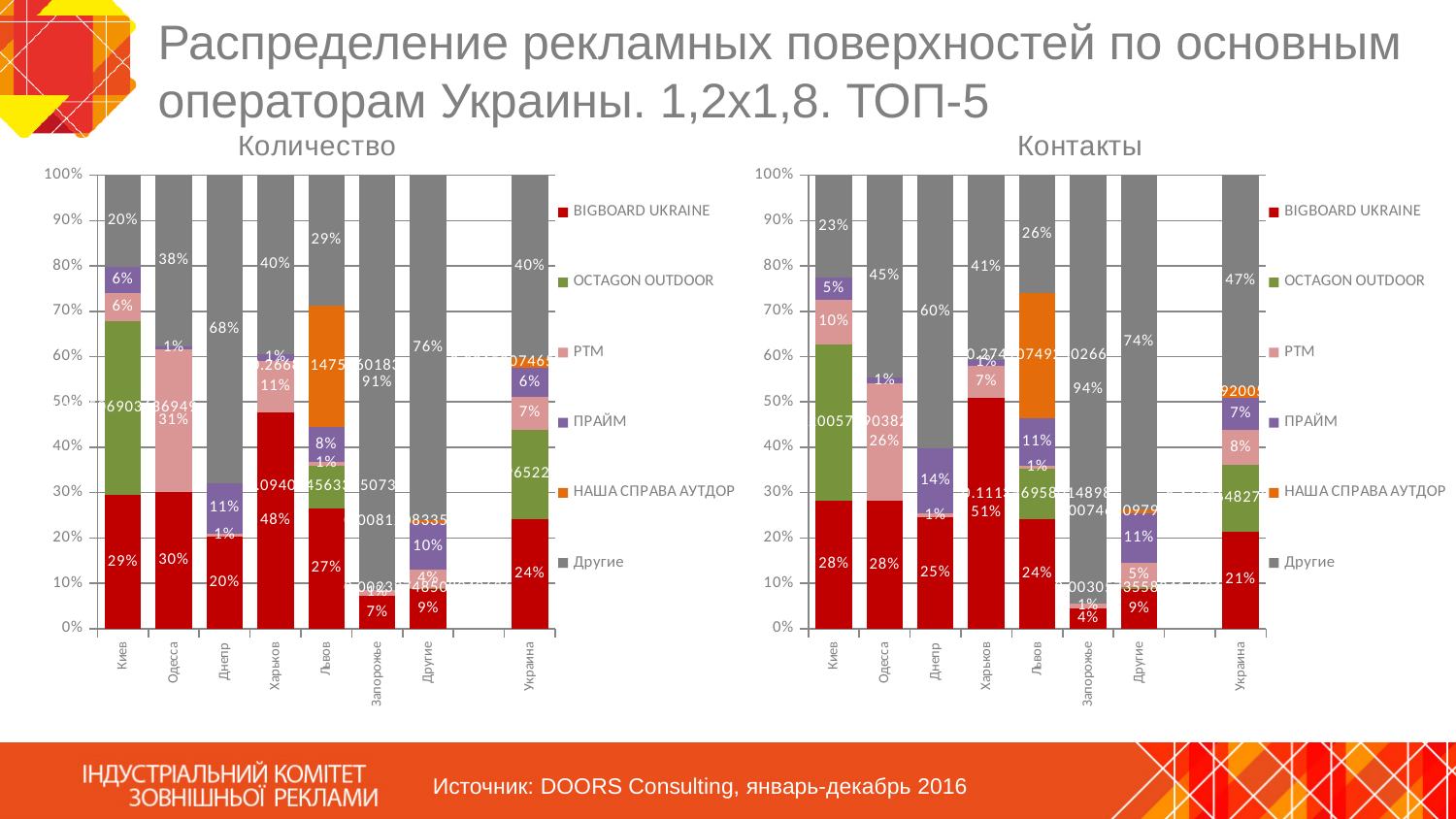
In the "Контакты" chart, what is the РТМ share for Одесса? 26% In the "Количество" chart, what is the Другие share for Запорожье? 91% In the "Контакты" chart, which category has the highest Другие share? Запорожье In the "Контакты" chart, what is the difference between the BIGBOARD UKRAINE share for Харьков and for Украина? 30% How many categories are shown on the x axis of the "Количество" chart? 8 In the "Контакты" chart, what is the BIGBOARD UKRAINE share for Харьков? 51% In the "Количество" chart, which category has the lowest BIGBOARD UKRAINE share? Запорожье In the "Количество" chart, which is larger: the BIGBOARD UKRAINE share for Одесса or for Днепр? Одесса Which series is shown in red in the legend of the "Количество" chart? BIGBOARD UKRAINE How many series does the legend of the "Контакты" chart list? 6 What kind of chart is the "Количество" chart? stacked bar chart In the "Количество" chart, what is the BIGBOARD UKRAINE share for Харьков? 48%